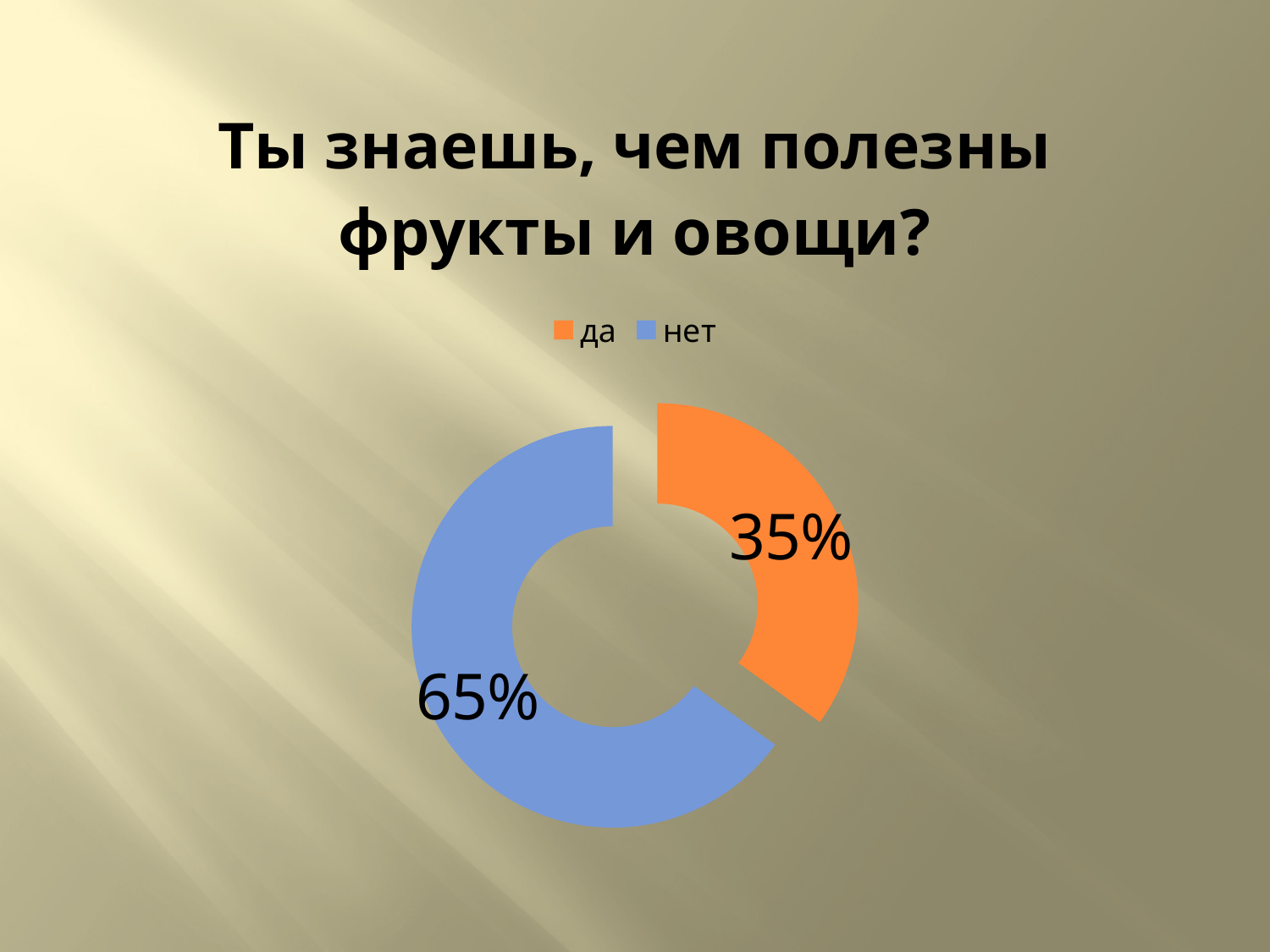
How many categories does the chart show? 2 What share of the chart does the "нет" slice take up? 65% What is the title of the chart? Ты знаешь, чем полезны фрукты и овощи? What is the difference in percentage points between the "нет" and "да" shares? 30 Which colour represents the "да" category in the legend? orange What percentage of respondents answered "нет"? 65% Which category has the largest share of the chart? нет Which category has the smallest share of the chart? да What kind of chart is shown on the slide? doughnut chart Which answer has the larger share, "да" or "нет"? нет What percentage of respondents answered "да"? 35%